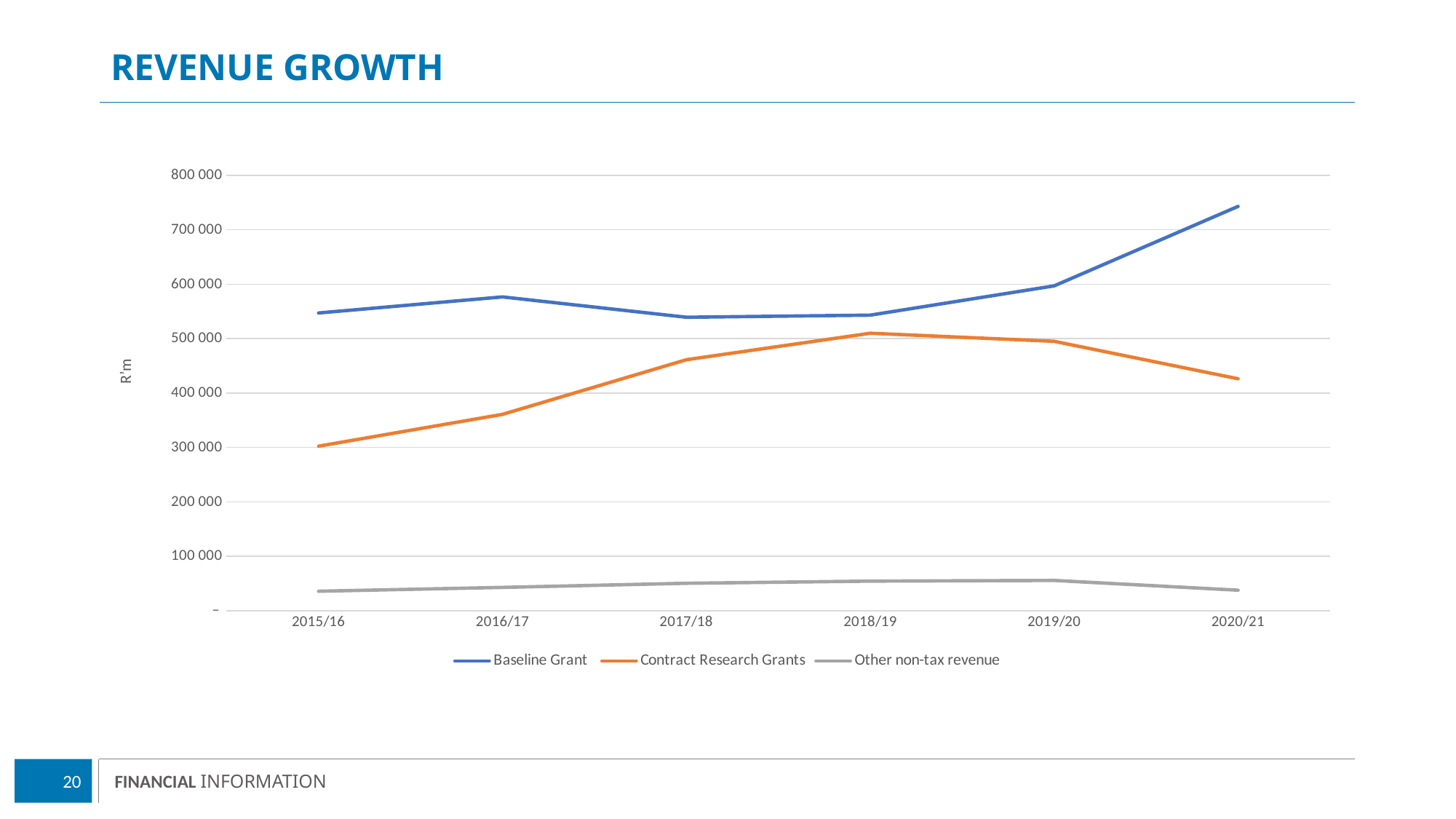
In 2020/21, which is larger: Baseline Grant or Contract Research Grants? Baseline Grant How many financial years are shown on the x axis? 6 Do Contract Research Grants rise or fall from 2018/19 to 2020/21? fall What type of chart is shown on the slide? line chart What is the label on the y axis? R'm Which series has the lowest values across all years? Other non-tax revenue Is the value for Other non-tax revenue in 2019/20 greater or less than 100 000? less How many series does the legend list? 3 In which year are Contract Research Grants lowest? 2015/16 Is the value for Contract Research Grants in 2015/16 greater or less than 400 000? less Is the value for Baseline Grant in 2020/21 greater or less than 700 000? greater In which year is the Baseline Grant highest? 2020/21